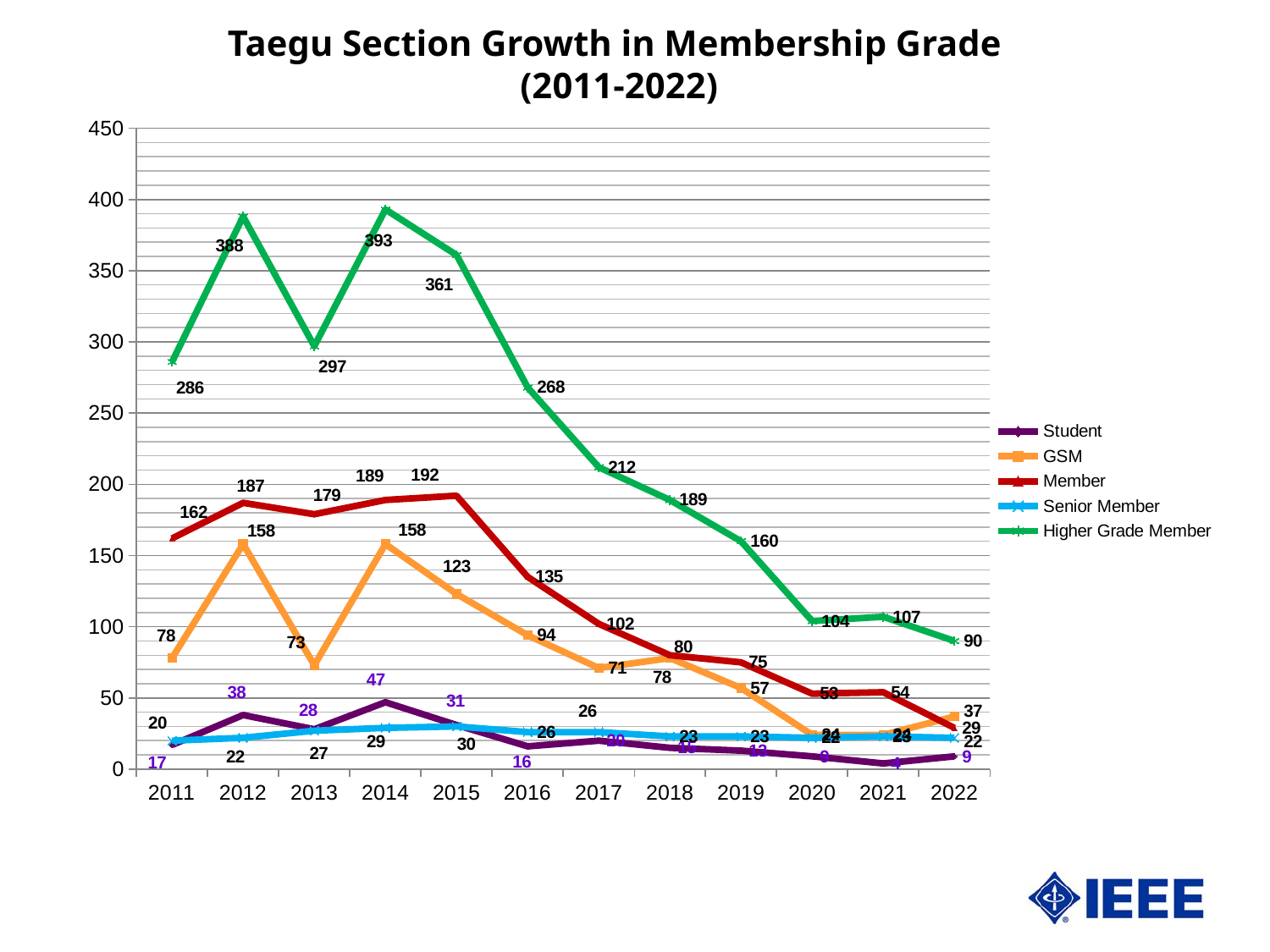
What is the value for Higher Grade Member in 2014? 393 How many years are plotted along the x axis? 12 What is the value for Student in 2014? 47 What is the value for Member in 2015? 192 How many series does the legend list? 5 What is the difference between the Higher Grade Member values in 2011 and 2022? 196 What kind of chart is shown on the slide? line chart In 2016, which is larger: the Member value or the GSM value? Member What is the value for GSM in 2012? 158 In which year is the Higher Grade Member series at its lowest? 2022 Does the Higher Grade Member series rise or fall from 2015 to 2022? fall In which year is the Higher Grade Member series at its highest? 2014